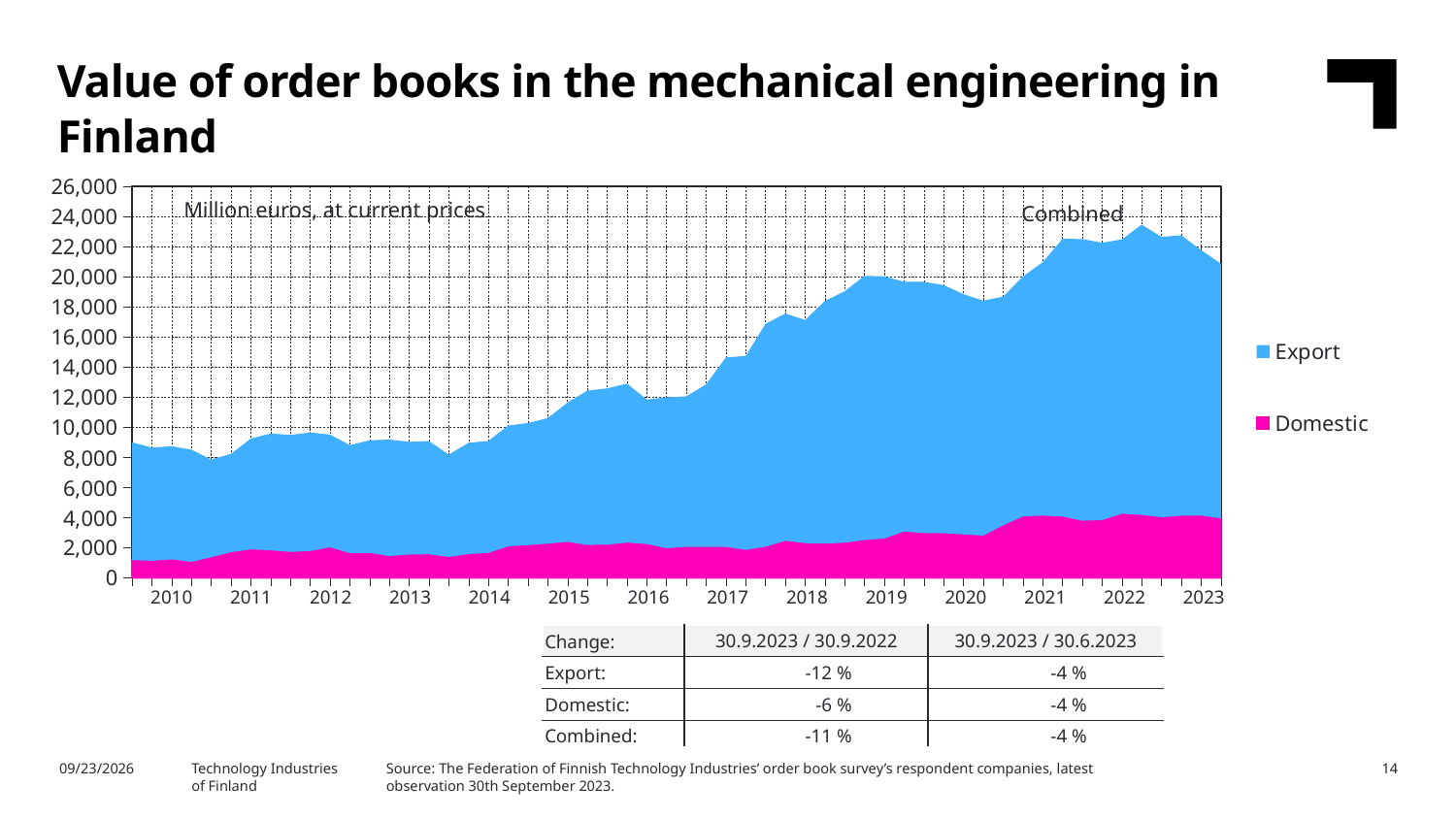
Does the combined value of order books rise or fall from 2022 to 2023? fall What are the two series named in the chart legend? Export and Domestic Is the combined value of order books at the end of 2023 greater or less than 16,000? greater Is the Domestic value at the start of 2010 greater or less than 2,000? less Which series is larger in 2023, Export or Domestic? Export What unit is stated on the chart for the values? Million euros, at current prices How many series does the chart legend list? 2 In which year does the combined value of order books reach its highest point? 2022 Is the combined value of order books at the start of 2010 greater or less than 10,000? less What kind of chart is shown on the slide? Stacked area chart How many years are labelled on the x axis of the chart? 14